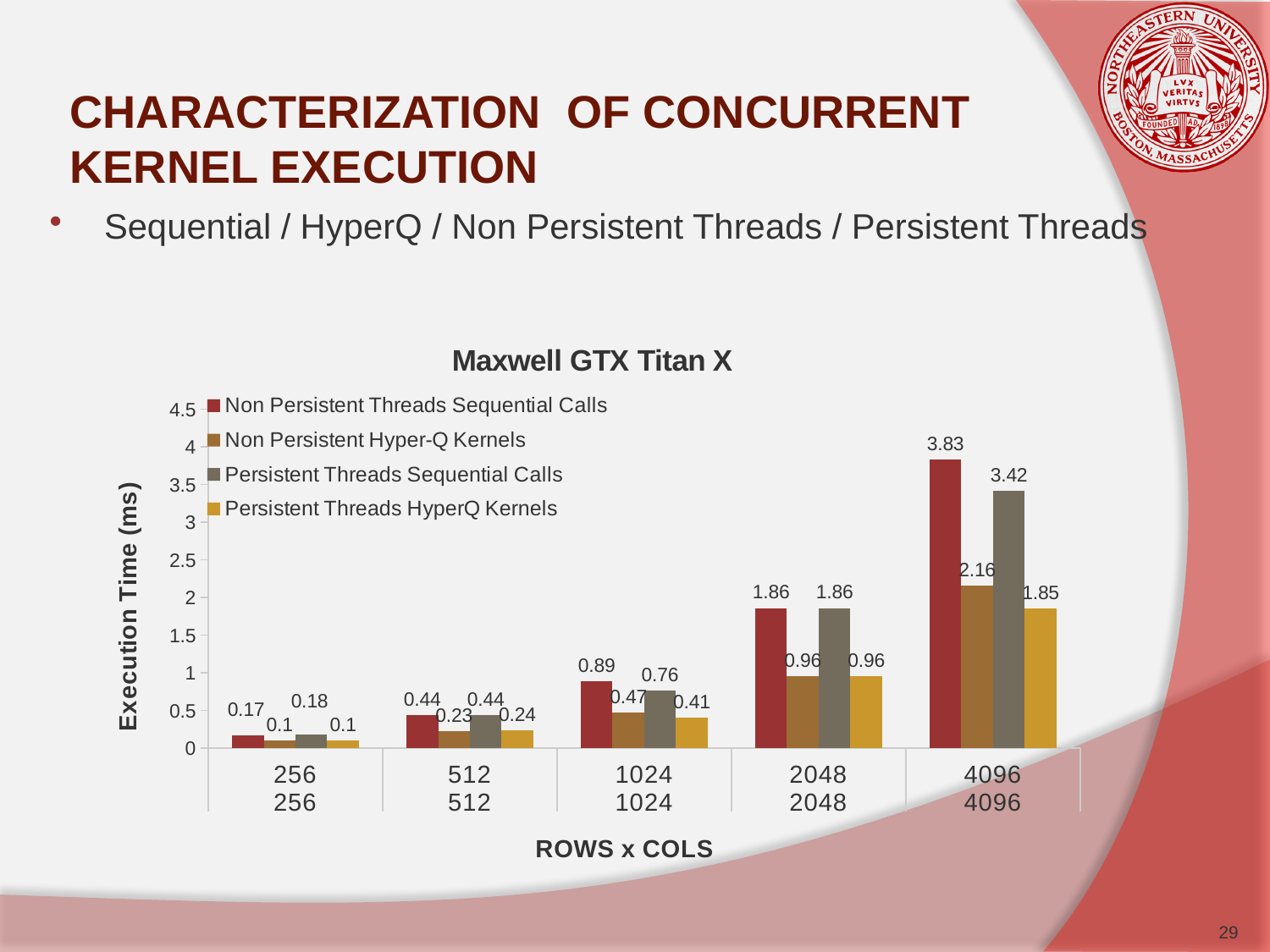
How does the execution time for Non Persistent Threads Sequential Calls change as ROWS x COLS increases from 256 x 256 to 4096 x 4096? It rises How many series does the legend list? 4 What is the execution time for Persistent Threads HyperQ Kernels at 1024 x 1024? 0.41 What is the difference between Non Persistent Threads Sequential Calls and Persistent Threads Sequential Calls at 4096 x 4096? 0.41 Which is larger at 1024 x 1024: Non Persistent Threads Sequential Calls or Persistent Threads Sequential Calls? Non Persistent Threads Sequential Calls What is the title of the chart? Maxwell GTX Titan X What is the execution time for Non Persistent Threads Sequential Calls at 4096 x 4096? 3.83 What is the execution time for Non Persistent Hyper-Q Kernels at 2048 x 2048? 0.96 What type of chart is shown on the slide? bar chart How many ROWS x COLS categories are shown on the x axis? 5 Which series has the lowest execution time at 4096 x 4096? Persistent Threads HyperQ Kernels Which series has the highest execution time at 4096 x 4096? Non Persistent Threads Sequential Calls